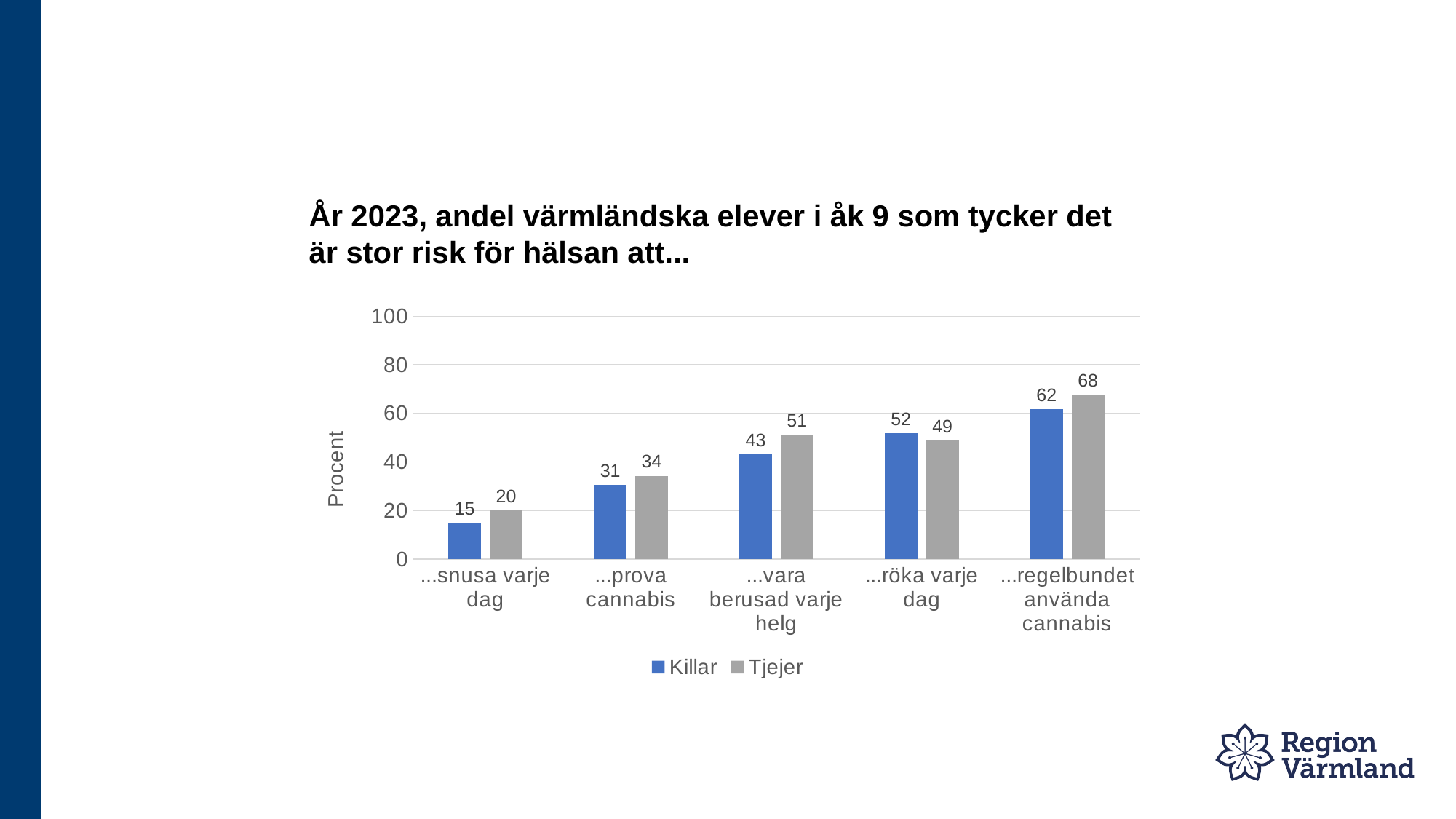
What is the value for Tjejer for "...vara berusad varje helg"? 51 Which category has the lowest value for Tjejer? ...snusa varje dag What is the label of the y axis? Procent What is the value for Killar for "...snusa varje dag"? 15 What is the difference between Tjejer and Killar for "...vara berusad varje helg"? 8 What kind of chart is shown on the slide? bar chart Is the value for Killar for "...prova cannabis" greater or less than 40? less How many series does the legend list? 2 Which category has the highest value for Killar? ...regelbundet använda cannabis How many categories are shown on the x axis? 5 What is the value for Tjejer for "...regelbundet använda cannabis"? 68 For "...röka varje dag", which series has the larger value, Killar or Tjejer? Killar